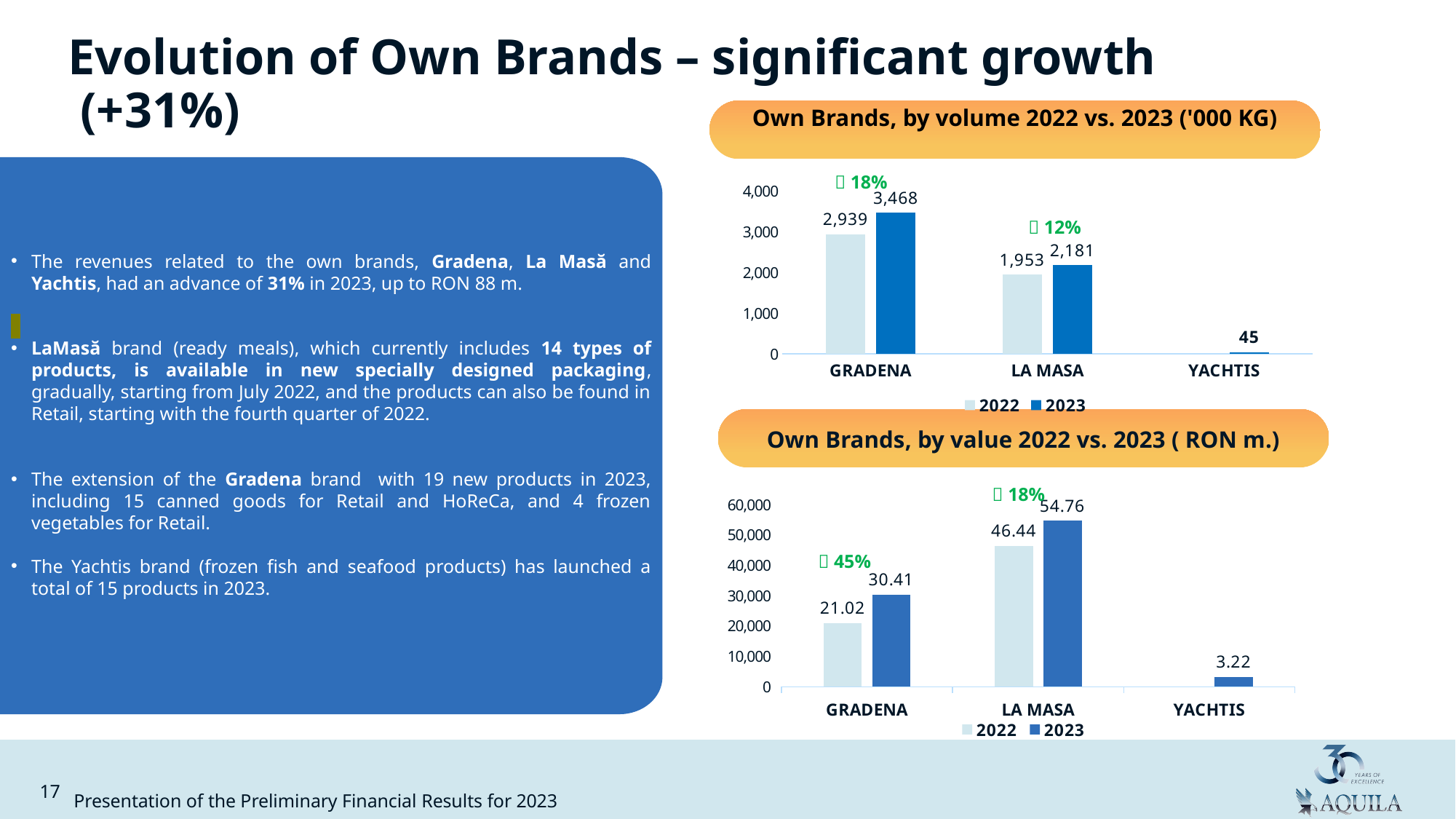
In the 'Own Brands, by volume 2022 vs. 2023' chart, how many series does the legend list? 2 In the 'Own Brands, by volume 2022 vs. 2023' chart, what is the 2023 value for GRADENA? 3,468 In the 'Own Brands, by value 2022 vs. 2023' chart, what is the 2022 value for GRADENA? 21.02 In the 'Own Brands, by value 2022 vs. 2023' chart, which brand has the lowest 2023 value? YACHTIS In the 'Own Brands, by volume 2022 vs. 2023' chart, what is the value shown for YACHTIS? 45 What type of chart is the 'Own Brands, by value 2022 vs. 2023' chart? Bar chart In the 'Own Brands, by volume 2022 vs. 2023' chart, what is the difference between the 2023 and 2022 values for GRADENA? 529 In the 'Own Brands, by value 2022 vs. 2023' chart, is the 2023 value for GRADENA or LA MASA larger? LA MASA In the 'Own Brands, by value 2022 vs. 2023' chart, what growth percentage is shown above GRADENA? 45% In the 'Own Brands, by value 2022 vs. 2023' chart, what is the 2023 value for LA MASA? 54.76 In the 'Own Brands, by volume 2022 vs. 2023' chart, which brand has the highest 2023 volume? GRADENA In the 'Own Brands, by volume 2022 vs. 2023' chart, what is the 2022 value for LA MASA? 1,953